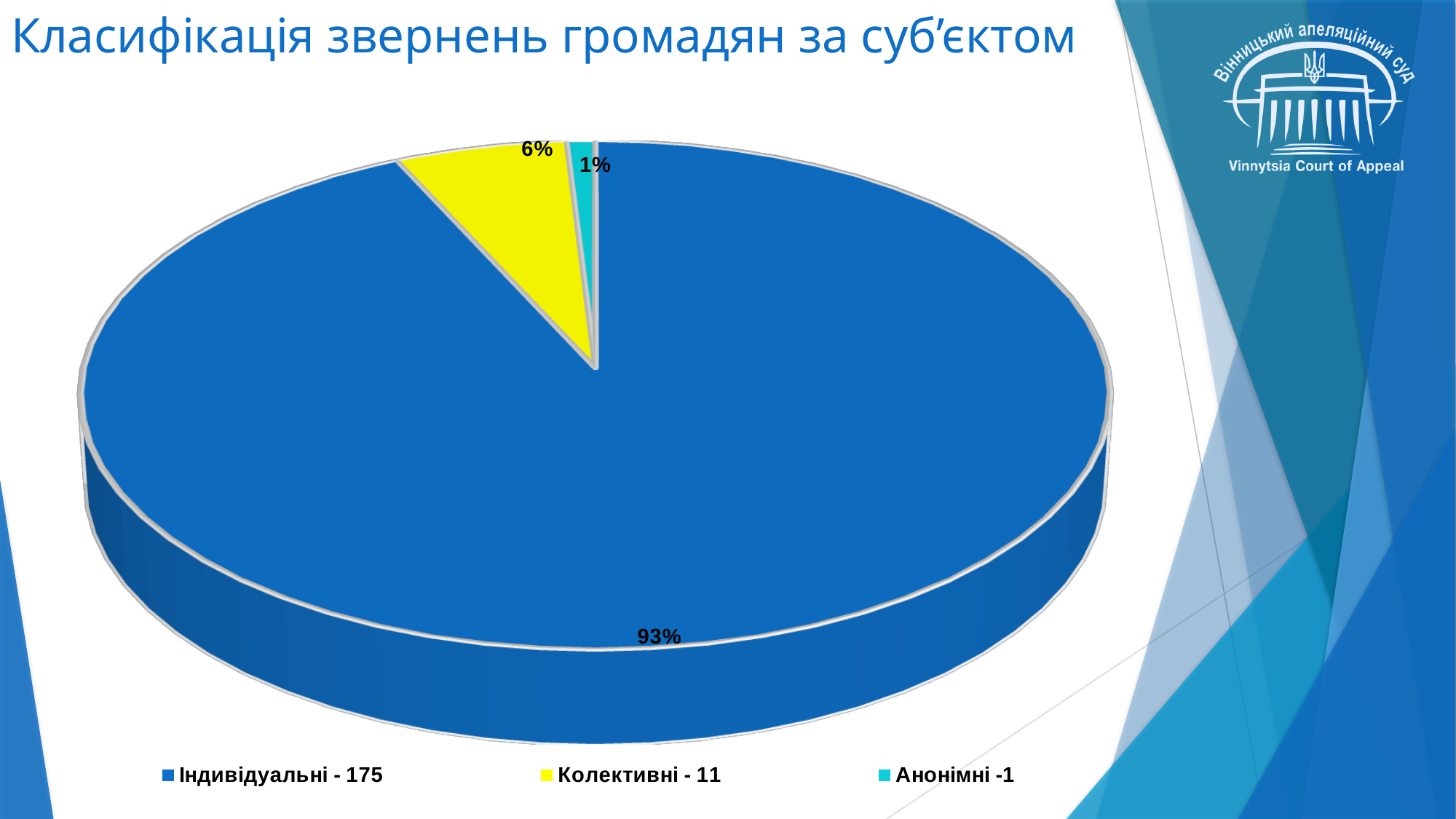
Which category has the smallest slice of the pie? Анонімні What percentage share does the slice for Індивідуальні have? 93% According to the legend, how many appeals are in the Індивідуальні category? 175 What kind of chart is shown on the slide? Pie chart Which is larger, the share for Колективні or the share for Анонімні? Колективні What is the difference in percentage points between the Індивідуальні slice and the Колективні slice? 87 What percentage share does the slice for Колективні have? 6% According to the legend, how many appeals are in the Колективні category? 11 Which category has the largest slice of the pie? Індивідуальні How many categories does the pie chart show? 3 What percentage share does the slice for Анонімні have? 1% What colour is the slice for Колективні? Yellow